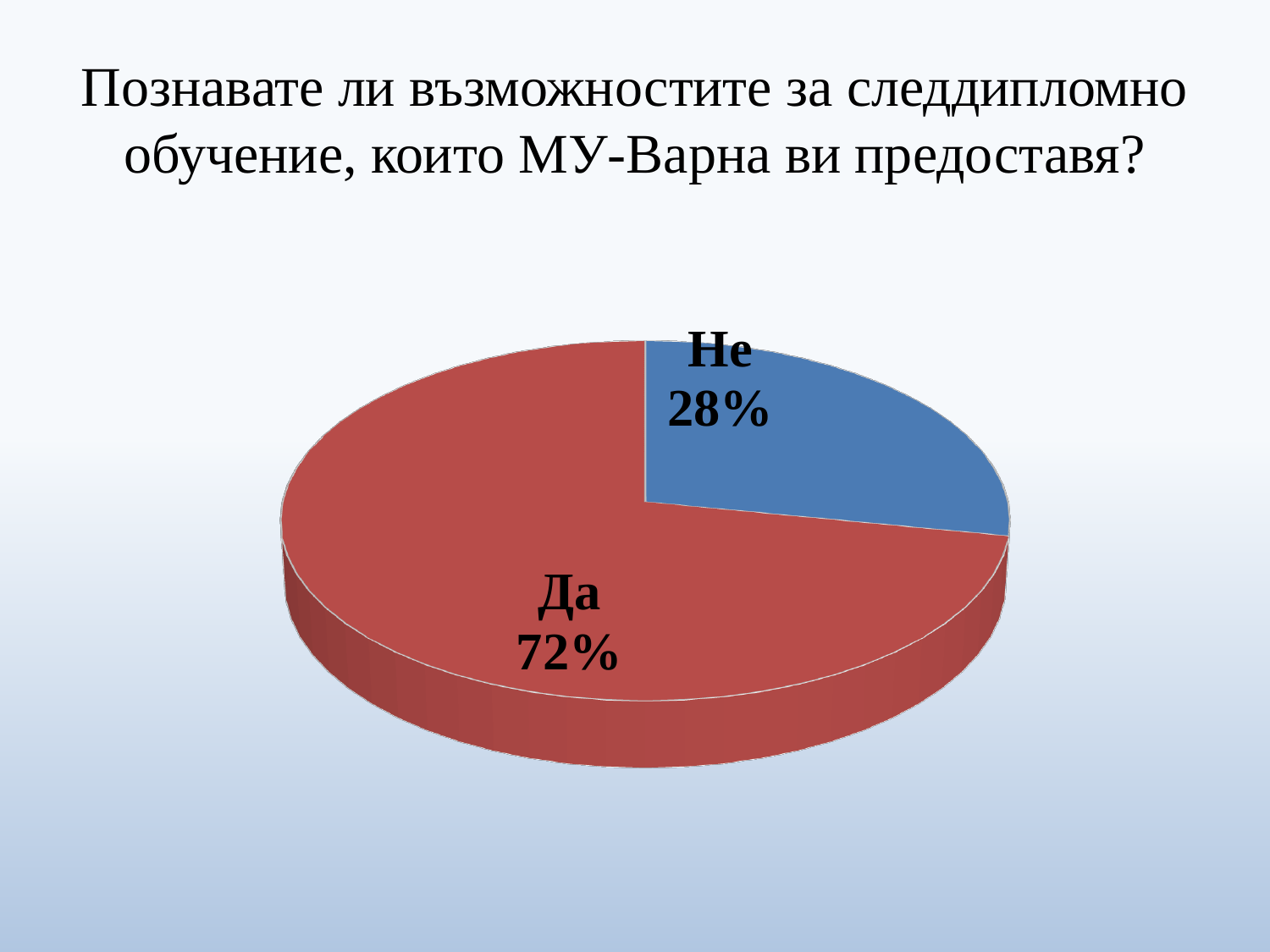
What percentage of respondents answered "Не"? 28% Which slice is the largest? Да What share of the pie does the "Не" slice represent? 28% What is the difference in percentage points between the "Да" and "Не" slices? 44 Which slice is the smallest? Не How many slices does the pie chart have? 2 What colour is the "Да" slice? red What colour is the "Не" slice? blue What percentage of respondents answered "Да"? 72% Which is larger, the "Да" slice or the "Не" slice? Да What kind of chart is shown on the slide? pie chart